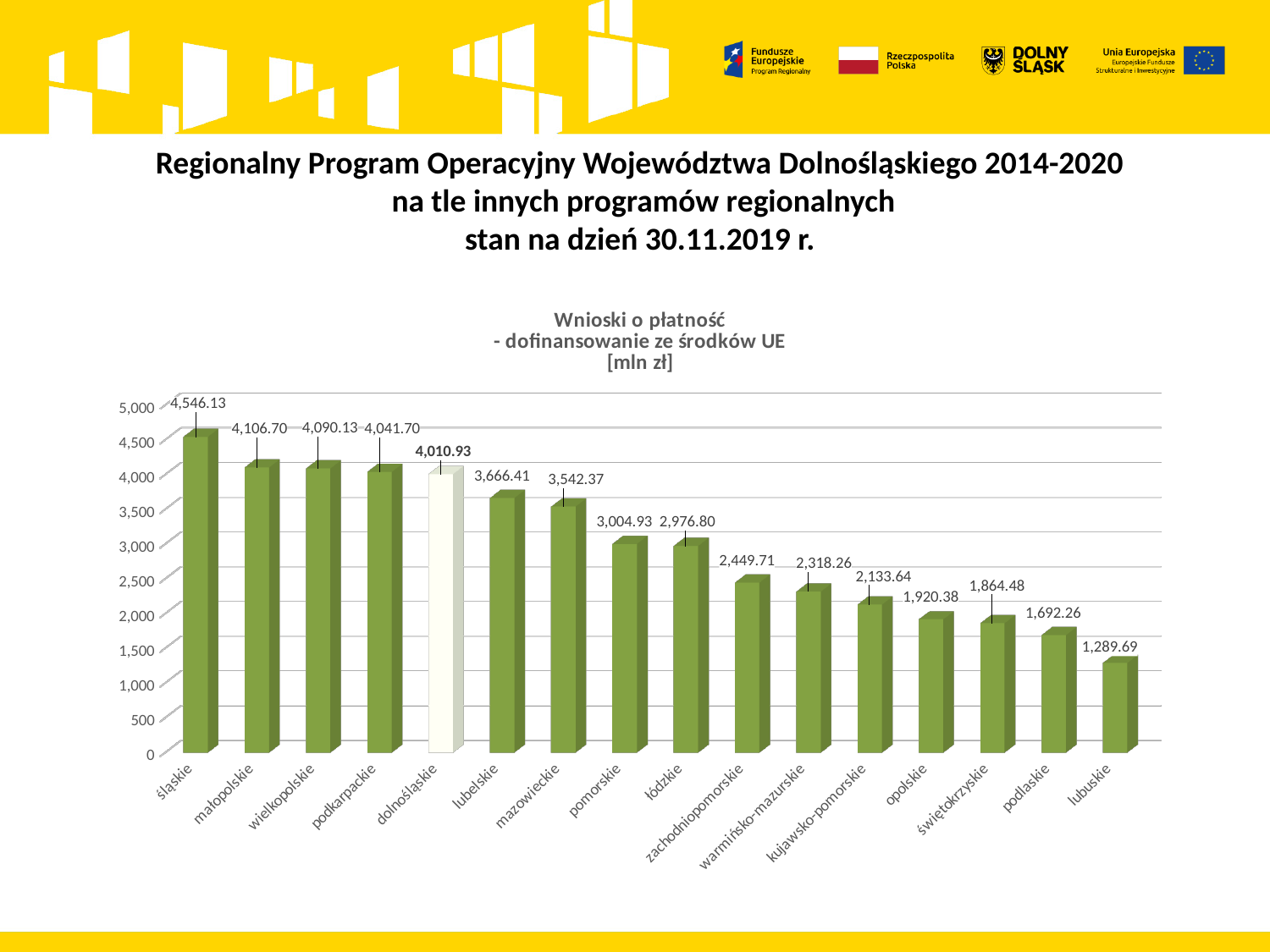
What unit is given in the chart title? mln zł What is the difference between the values for śląskie and dolnośląskie? 535.20 How many regions are shown on the chart? 16 Which region has the highest value? śląskie Which is larger, the value for opolskie or the value for świętokrzyskie? opolskie Do the values rise or fall from left to right along the x axis? fall What is the value for lubuskie? 1,289.69 What kind of chart is shown on the slide? bar chart What is the value for mazowieckie? 3,542.37 Which region has the lowest value? lubuskie What is the difference between the values for lubelskie and mazowieckie? 124.04 What is the value for dolnośląskie? 4,010.93